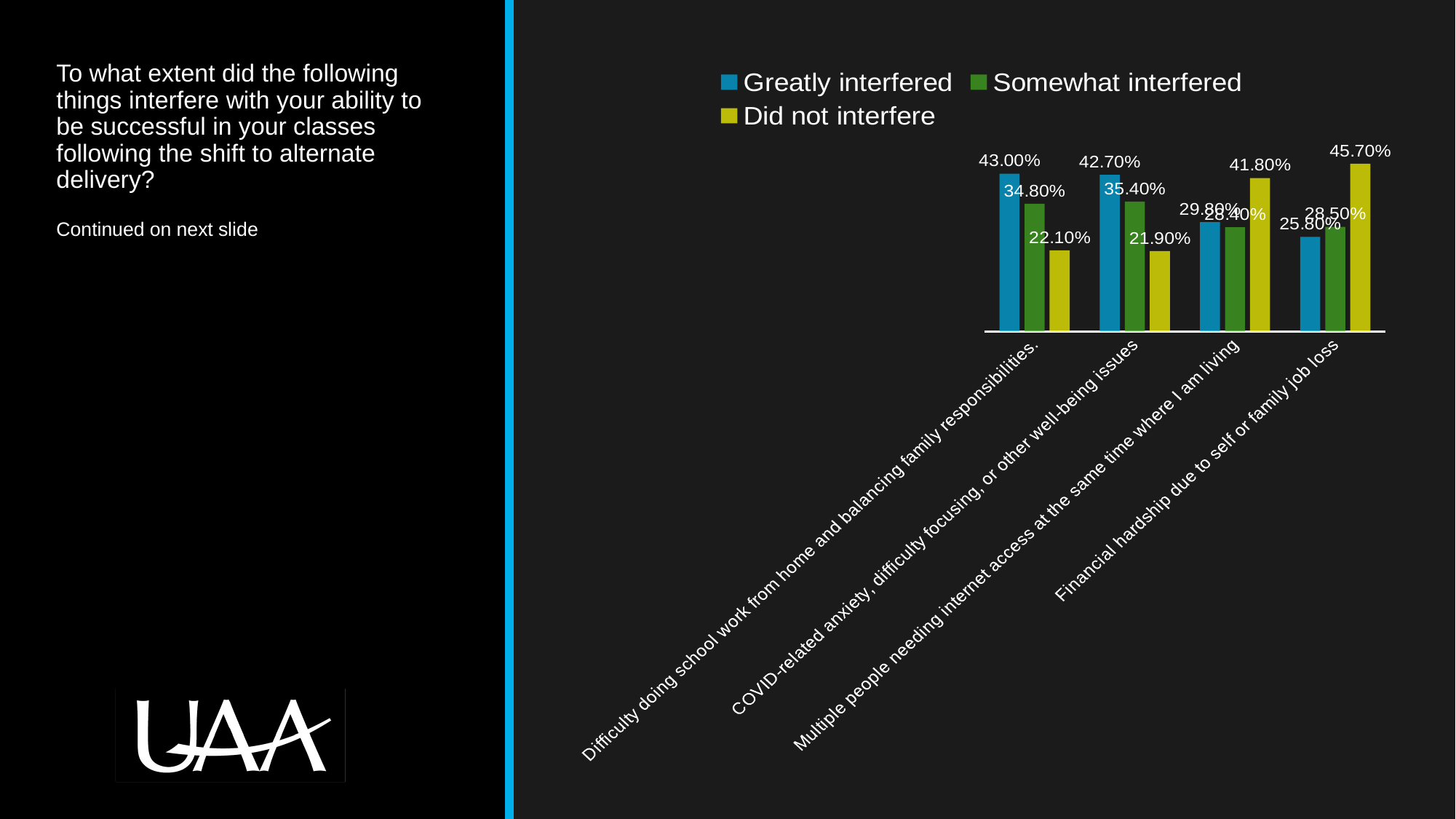
What colour represents the 'Did not interfere' series in the chart? yellow What is the difference between the 'Greatly interfered' and 'Did not interfere' values for 'Difficulty doing school work from home and balancing family responsibilities'? 20.90% What is the 'Did not interfere' value for 'COVID-related anxiety, difficulty focusing, or other well-being issues'? 21.90% How many series does the chart legend list? 3 Which category has the lowest 'Greatly interfered' value? Financial hardship due to self or family job loss Which category has the highest 'Did not interfere' value? Financial hardship due to self or family job loss How many categories are shown along the x axis of the chart? 4 What kind of chart is shown on the slide? bar chart What is the 'Somewhat interfered' value for 'COVID-related anxiety, difficulty focusing, or other well-being issues'? 35.40% Which is larger: the 'Did not interfere' value for 'Financial hardship due to self or family job loss' or for 'Multiple people needing internet access at the same time where I am living'? Financial hardship due to self or family job loss What is the 'Greatly interfered' value for 'Difficulty doing school work from home and balancing family responsibilities'? 43.00% What is the 'Did not interfere' value for 'Financial hardship due to self or family job loss'? 45.70%